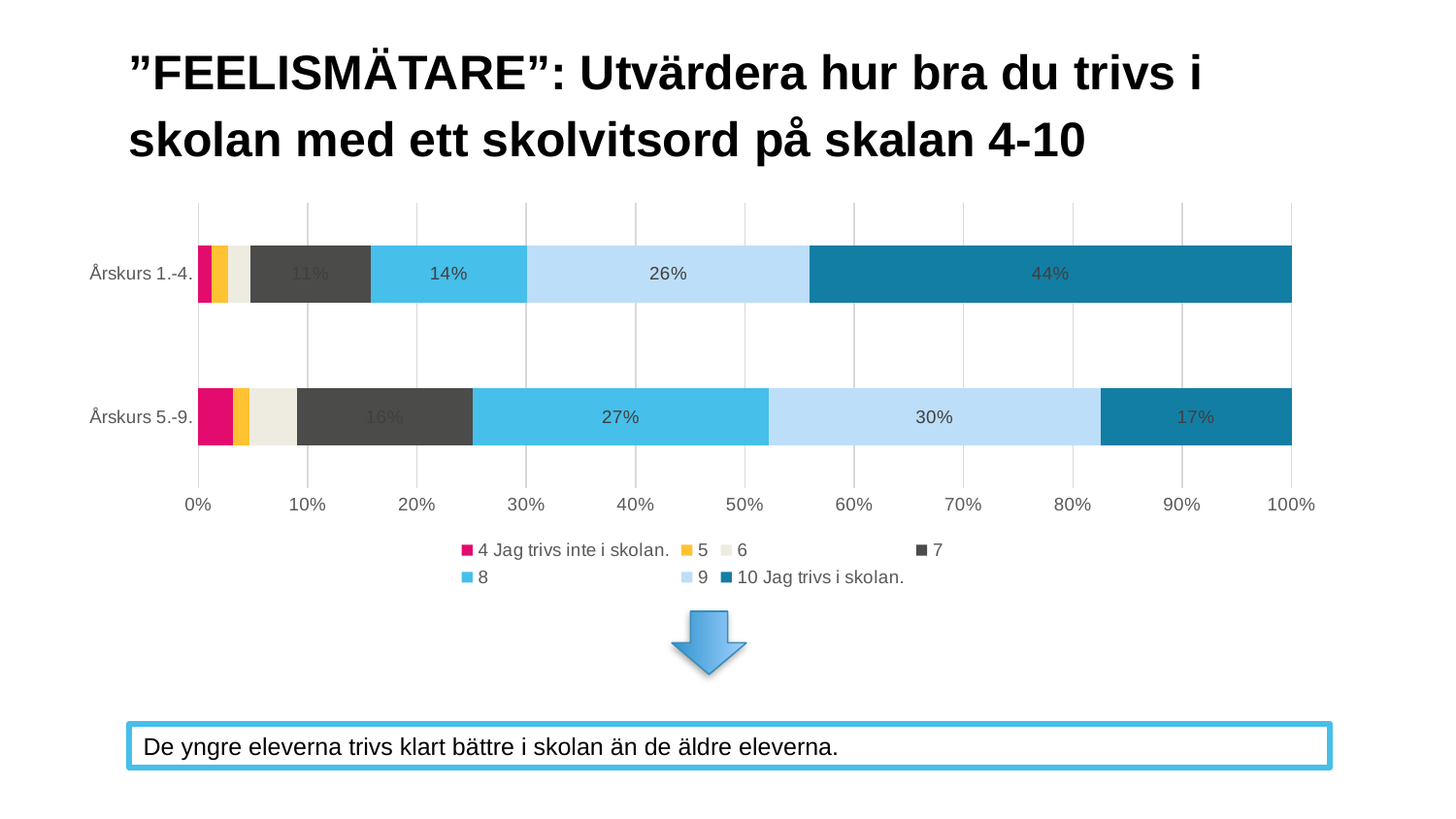
How many groups (categories) are shown on the y axis of the chart? 2 What percentage of Årskurs 1.-4. gave the rating 10 (Jag trivs i skolan)? 44% What kind of chart is shown on the slide? Stacked bar chart Which group has the larger share of rating 8: Årskurs 1.-4. or Årskurs 5.-9.? Årskurs 5.-9. What is the difference between the share of Årskurs 1.-4. and Årskurs 5.-9. who gave the rating 10? 27% What percentage of Årskurs 5.-9. gave the rating 9? 30% What percentage of Årskurs 5.-9. gave the rating 8? 27% What percentage of Årskurs 5.-9. gave the rating 10 (Jag trivs i skolan)? 17% Which group has the larger share of rating 10: Årskurs 1.-4. or Årskurs 5.-9.? Årskurs 1.-4. What percentage of Årskurs 1.-4. gave the rating 7? 11% How many series does the chart legend list? 7 Is the share of Årskurs 5.-9. who gave the rating 4 (Jag trivs inte i skolan) greater or less than 10%? less